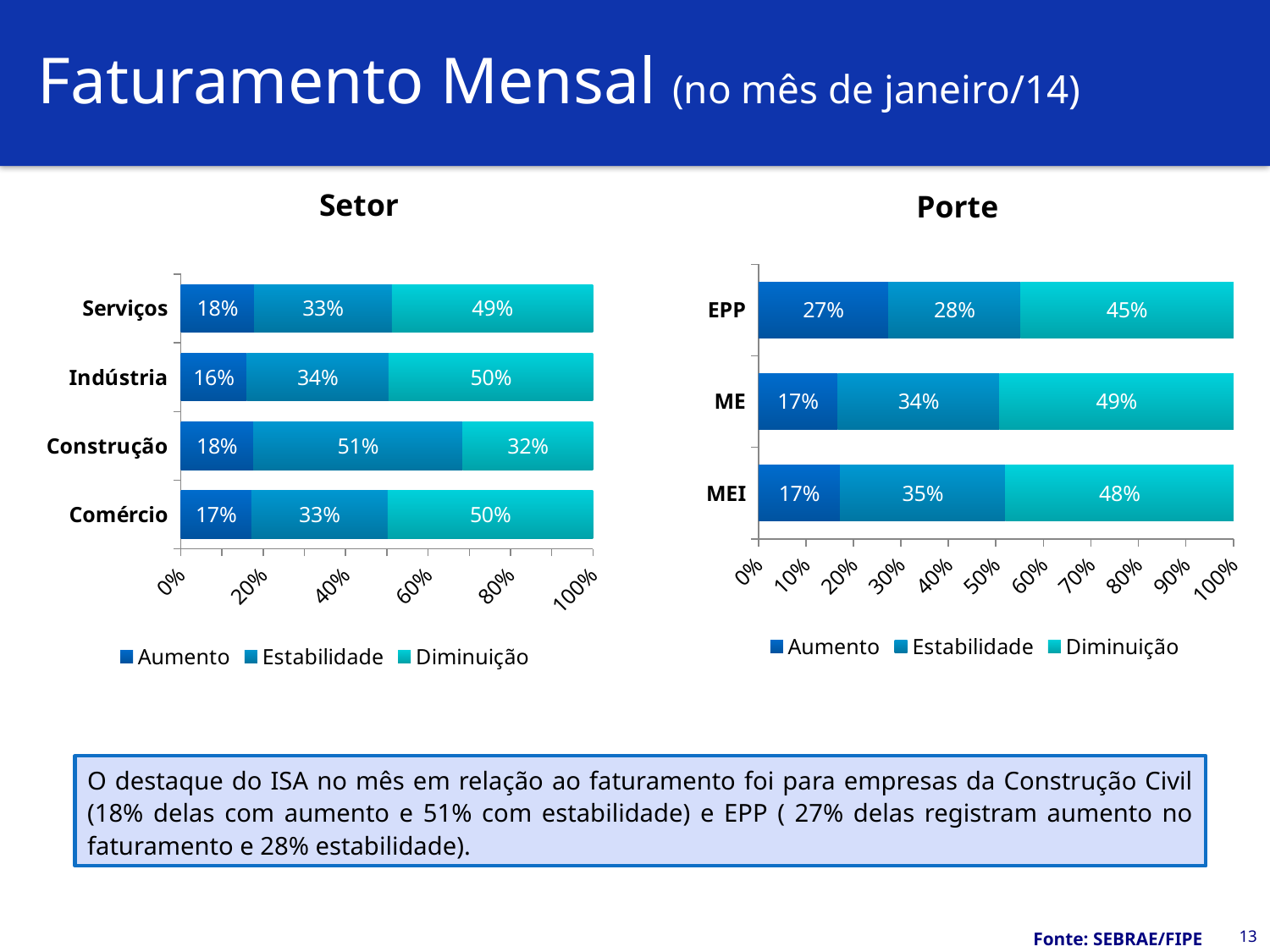
In the Setor chart, what is the Diminuição value for Indústria? 50% What kind of chart is the Porte chart? Stacked bar chart In the Porte chart, what is the Diminuição value for MEI? 48% How many series does the legend of the Porte chart list? 3 How many categories are shown in the Setor chart? 4 In the Setor chart, which category has the lowest Diminuição value? Construção In the Porte chart, what is the Aumento value for EPP? 27% In the Porte chart, what is the difference between the Diminuição values for EPP and ME? 4% In the Setor chart, what is the Estabilidade value for Construção? 51% In the Setor chart, which is larger: the Estabilidade value for Construção or the Estabilidade value for Indústria? Construção In the Porte chart, which category has the highest Aumento value? EPP In the Setor chart, which category has the highest Estabilidade value? Construção